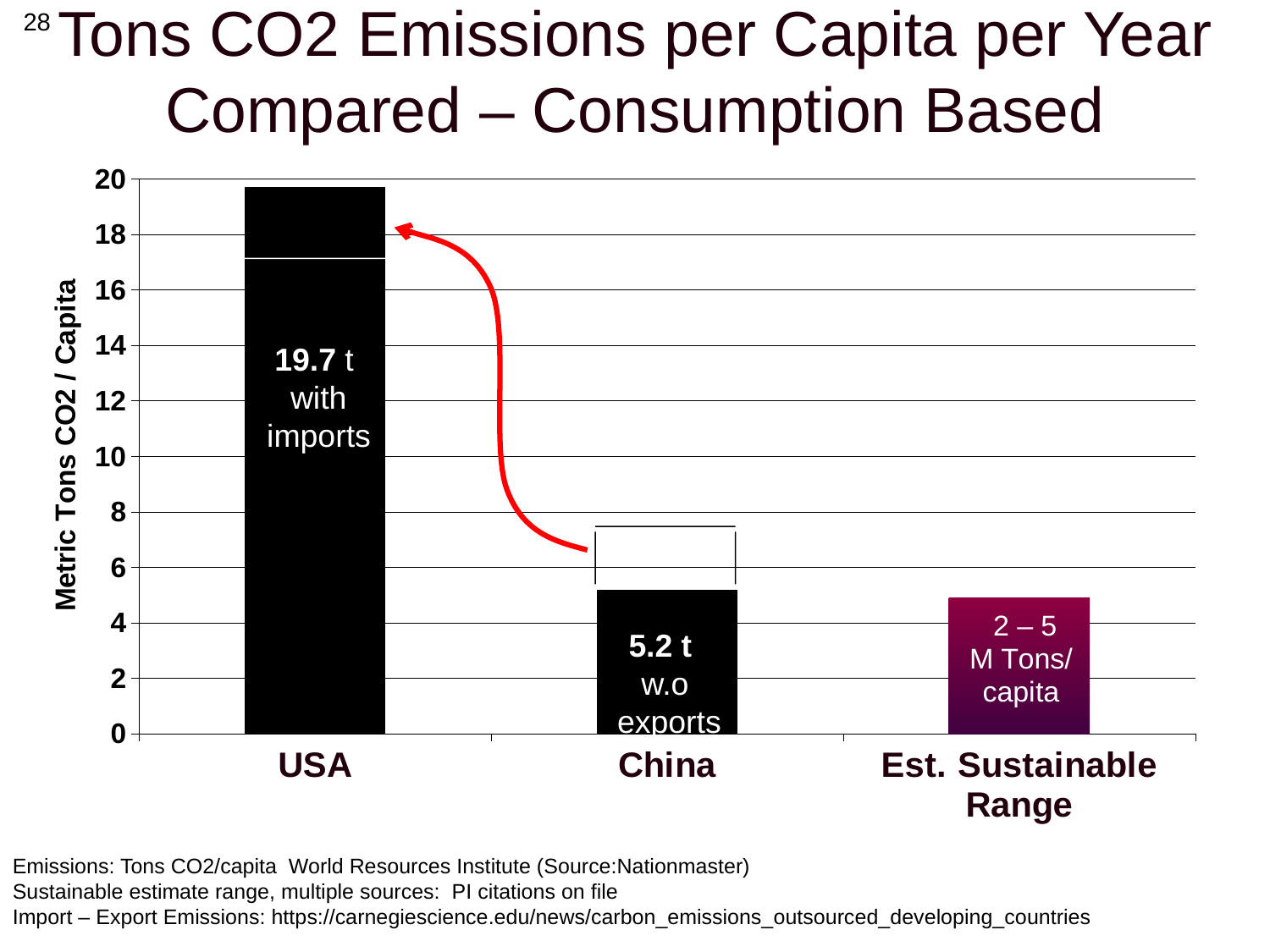
Which is larger, the value for the USA or the value for China? USA What range is labelled on the Est. Sustainable Range bar? 2 – 5 M Tons/capita What is the difference between the USA value and the China value? 14.5 t What type of chart is shown on the slide? bar chart Which category has the highest value in the chart? USA What is the CO2 emissions value shown for the USA? 19.7 t What is the title of the y axis? Metric Tons CO2 / Capita What is the CO2 emissions value shown for China? 5.2 t How many categories are shown on the x axis? 3 Is the value for the USA greater or less than 18? greater Do the bar values rise or fall from left to right across the x axis? fall Is the value for China greater or less than 8? less